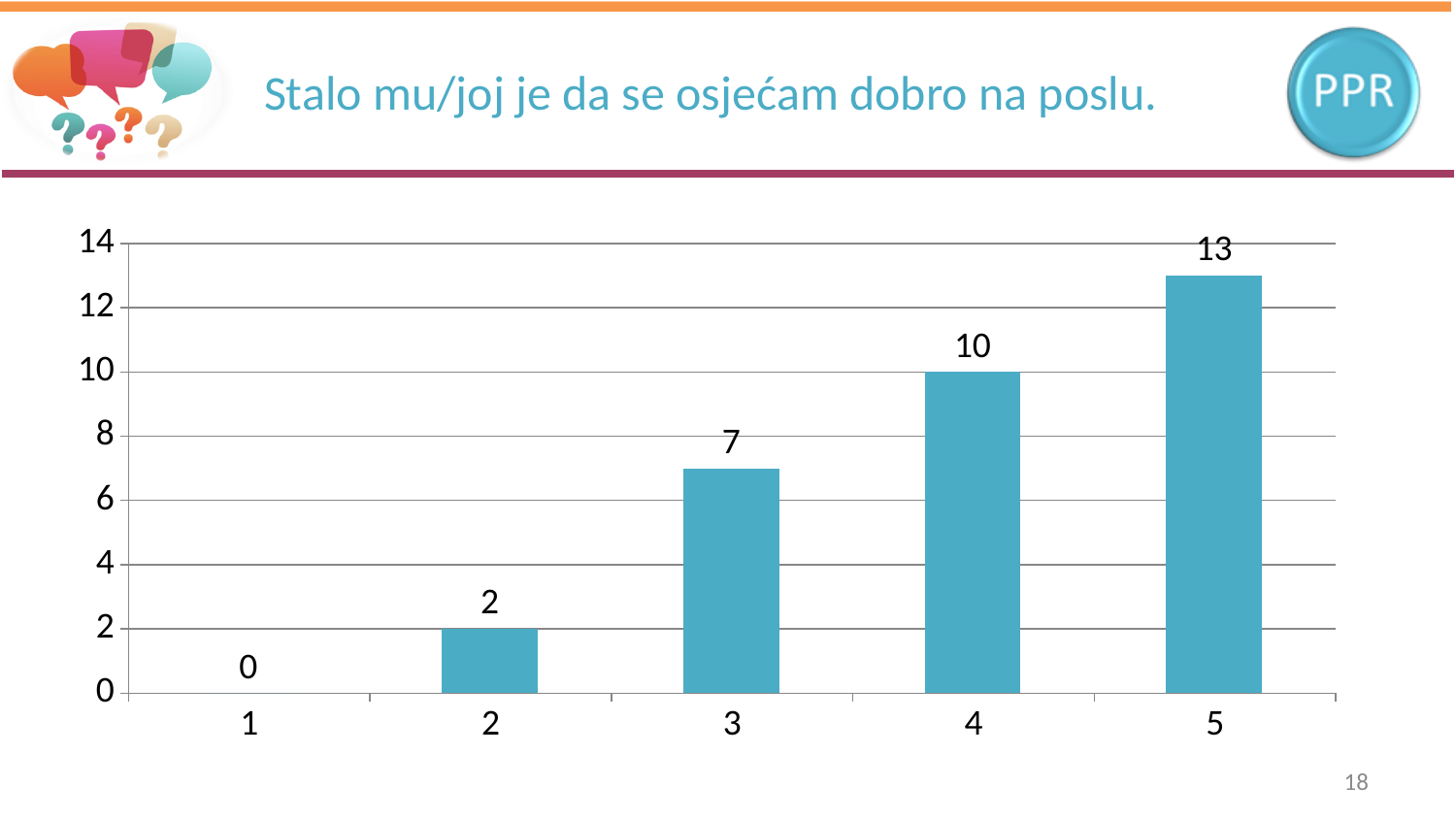
Do the values rise or fall from category 1 to category 5? rise What is the difference between the values for categories 3 and 2? 5 Which is larger, the value for category 2 or the value for category 4? 4 What is the value for category 1? 0 Which category has the highest value? 5 What is the value for category 3? 7 What is the value for category 5? 13 What is the difference between the values for categories 5 and 4? 3 Which category has the lowest value? 1 Is the value for category 4 greater or less than 8? greater How many categories are shown on the x axis? 5 What kind of chart is shown on the slide? bar chart